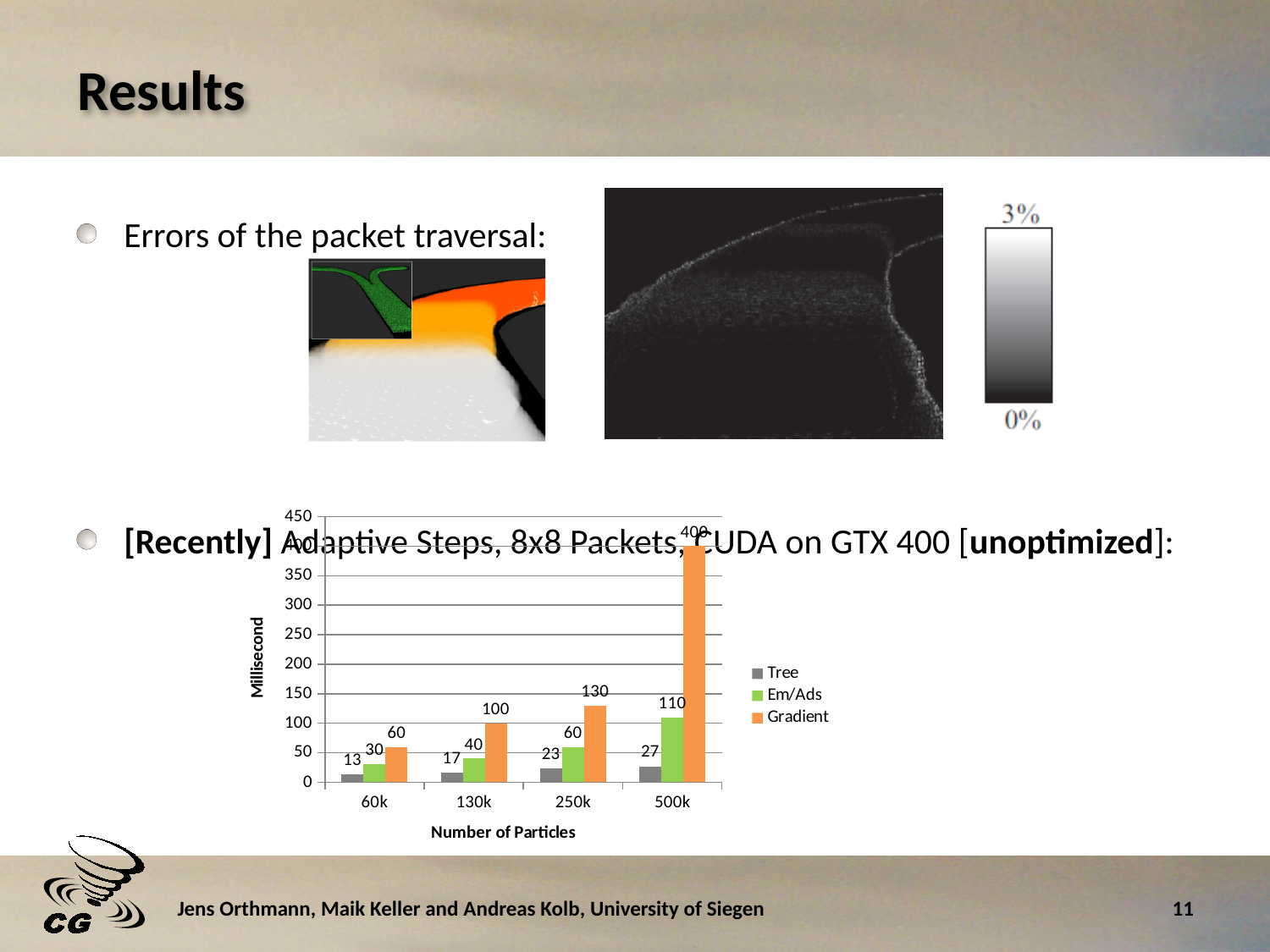
Which number of particles has the highest Gradient value? 500k Which number of particles has the lowest Tree value? 60k Which is larger at 130k particles, the Gradient value or the Em/Ads value? Gradient What is the difference between the Gradient and Em/Ads values at 250k particles? 70 What is the Tree value for 60k particles? 13 What is the Em/Ads value for 500k particles? 110 Does the Tree value rise or fall as the number of particles increases? Rises How many particle-count categories are shown on the x axis? 4 What is the Em/Ads value for 130k particles? 40 What kind of chart is shown on the slide? Bar chart What is the Gradient value for 250k particles? 130 How many series does the legend list? 3